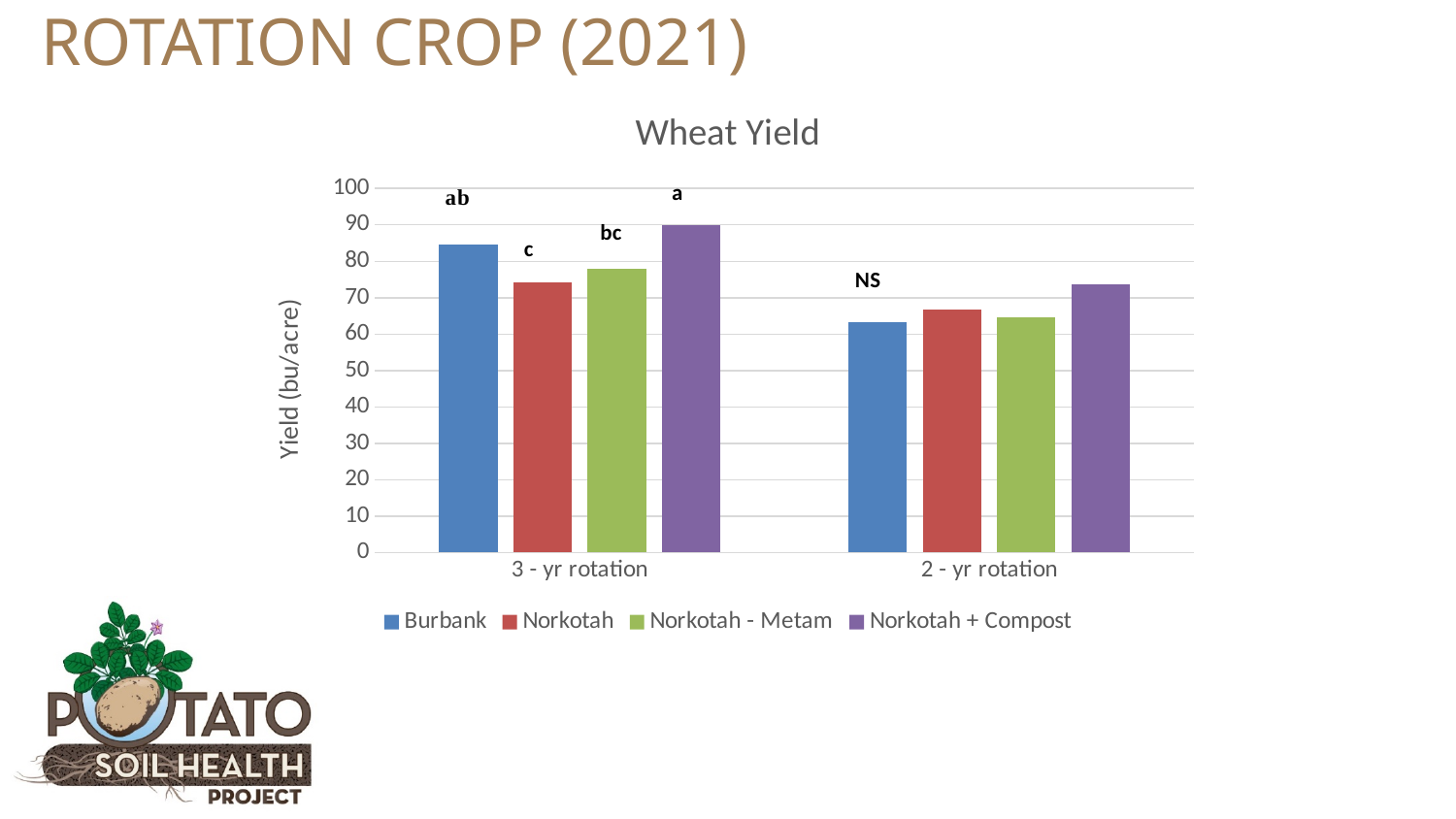
Is the Burbank value for the 3 - yr rotation greater or less than 80? greater Is the Norkotah value for the 3 - yr rotation greater or less than 80? less What kind of chart is shown on the slide? bar chart Which is larger: the Burbank yield in the 3 - yr rotation or in the 2 - yr rotation? 3 - yr rotation In the 3 - yr rotation group, which series has the highest wheat yield? Norkotah + Compost What is the label on the vertical axis? Yield (bu/acre) In the 3 - yr rotation group, which series has the lowest wheat yield? Norkotah Is the Burbank value for the 2 - yr rotation greater or less than 70? less In the 2 - yr rotation group, which series has the highest wheat yield? Norkotah + Compost What is the title of the chart? Wheat Yield How many series does the legend list? 4 How many rotation categories are shown on the x axis? 2